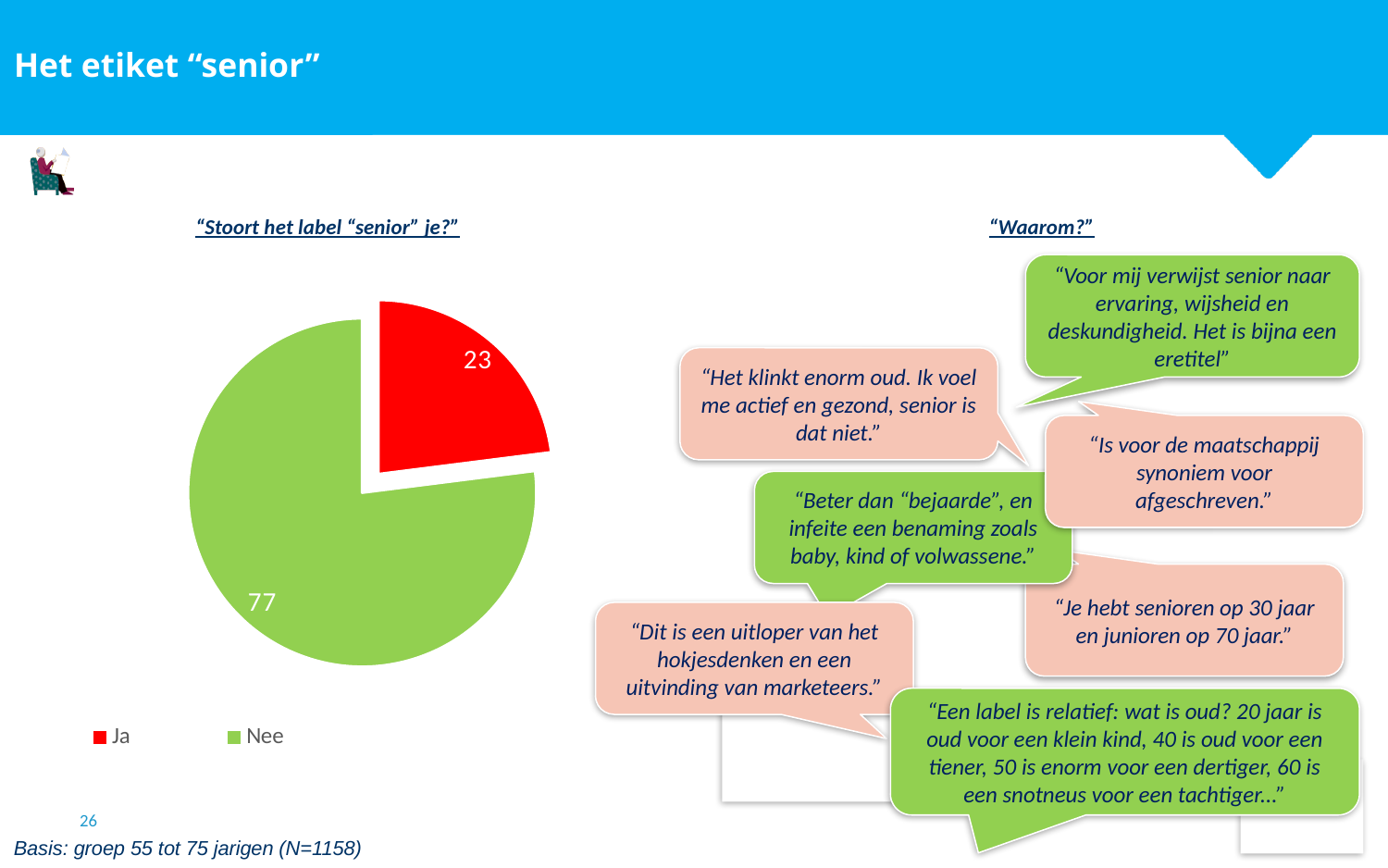
How many entries does the legend of the pie chart list? 2 How many slices does the pie chart have? 2 What is the difference between the values for "Nee" and "Ja" in the pie chart? 54 What colour is the "Ja" slice in the pie chart? red Which slice of the pie chart is the smallest? Ja Which slice of the pie chart is the largest? Nee What is the value for "Ja" in the pie chart? 23 Which is larger in the pie chart, "Ja" or "Nee"? Nee What is the value for "Nee" in the pie chart? 77 What question is the pie chart titled with? "Stoort het label "senior" je?" What is the total of the two values shown in the pie chart? 100 What kind of chart is shown on the slide? pie chart